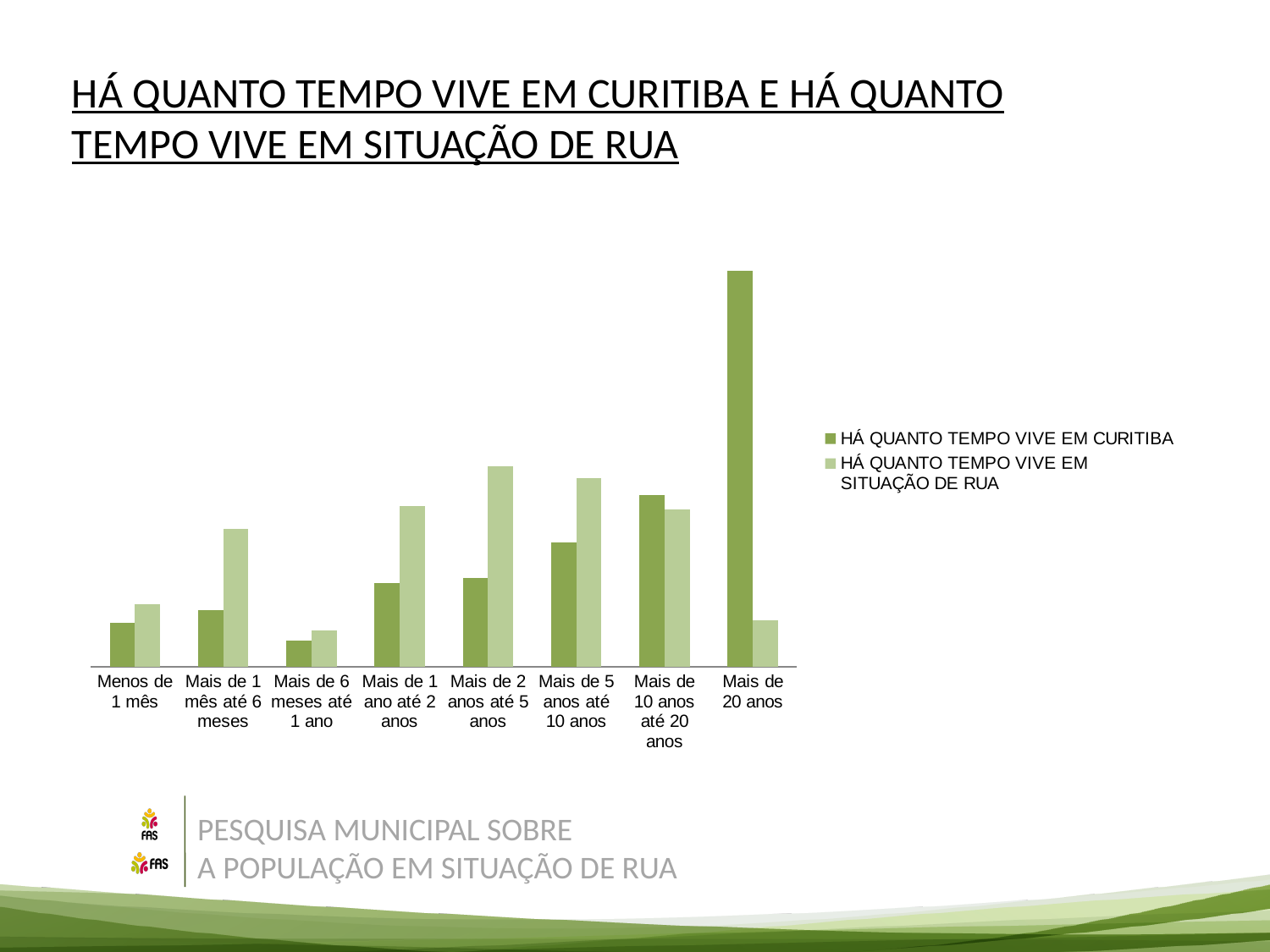
In the category 'Mais de 2 anos até 5 anos', which series has the larger value? HÁ QUANTO TEMPO VIVE EM SITUAÇÃO DE RUA Which series is shown in the darker green bars? HÁ QUANTO TEMPO VIVE EM CURITIBA How many categories are shown on the x axis of the chart? 8 For the series 'HÁ QUANTO TEMPO VIVE EM CURITIBA', which is larger: 'Mais de 1 ano até 2 anos' or 'Mais de 5 anos até 10 anos'? Mais de 5 anos até 10 anos What kind of chart is shown on the slide? bar chart How many series does the chart's legend list? 2 For the series 'HÁ QUANTO TEMPO VIVE EM CURITIBA', do the values rise or fall from 'Mais de 6 meses até 1 ano' to 'Mais de 20 anos'? rise In the category 'Mais de 20 anos', which series has the larger value? HÁ QUANTO TEMPO VIVE EM CURITIBA What is the title of the chart on the slide? HÁ QUANTO TEMPO VIVE EM CURITIBA E HÁ QUANTO TEMPO VIVE EM SITUAÇÃO DE RUA For the series 'HÁ QUANTO TEMPO VIVE EM CURITIBA', which category has the lowest value? Mais de 6 meses até 1 ano For the series 'HÁ QUANTO TEMPO VIVE EM CURITIBA', which category has the highest value? Mais de 20 anos